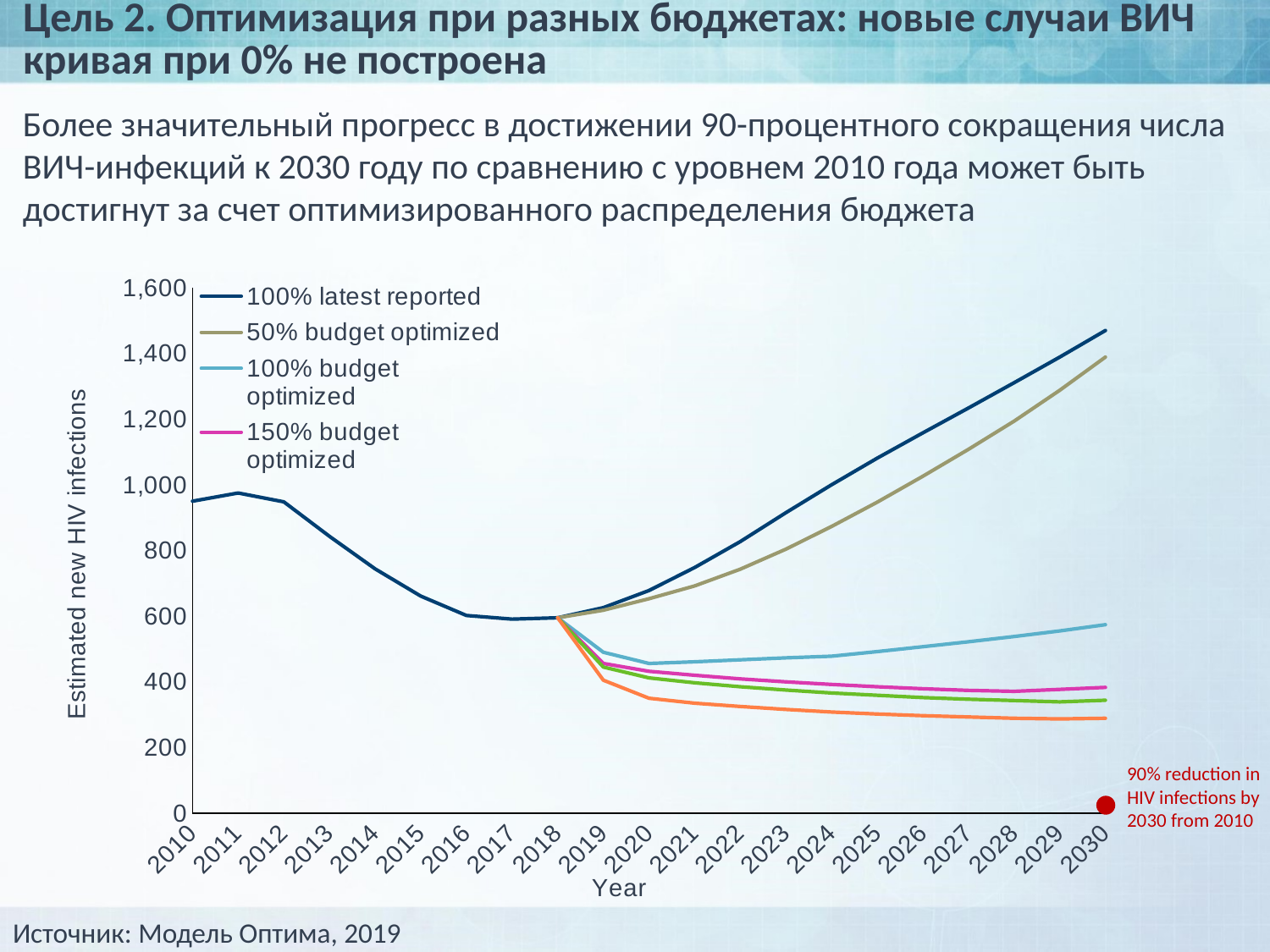
Is the value of the '100% budget optimized' series in 2030 greater or less than 600? less What kind of chart is shown on the slide? line chart Which series has the highest value in 2030? 100% latest reported Is the value of the '100% latest reported' series in 2010 greater or less than 1,000? less In 2030, which is larger: the '50% budget optimized' series or the '100% budget optimized' series? 50% budget optimized How many series does the chart's legend list? 4 What is the label of the horizontal axis of the chart? Year What is the label of the vertical axis of the chart? Estimated new HIV infections Is the value of the '100% latest reported' series in 2030 greater or less than 1,400? greater How many years are shown along the x axis of the chart? 21 Does the '100% latest reported' series rise or fall from 2018 to 2030? rise